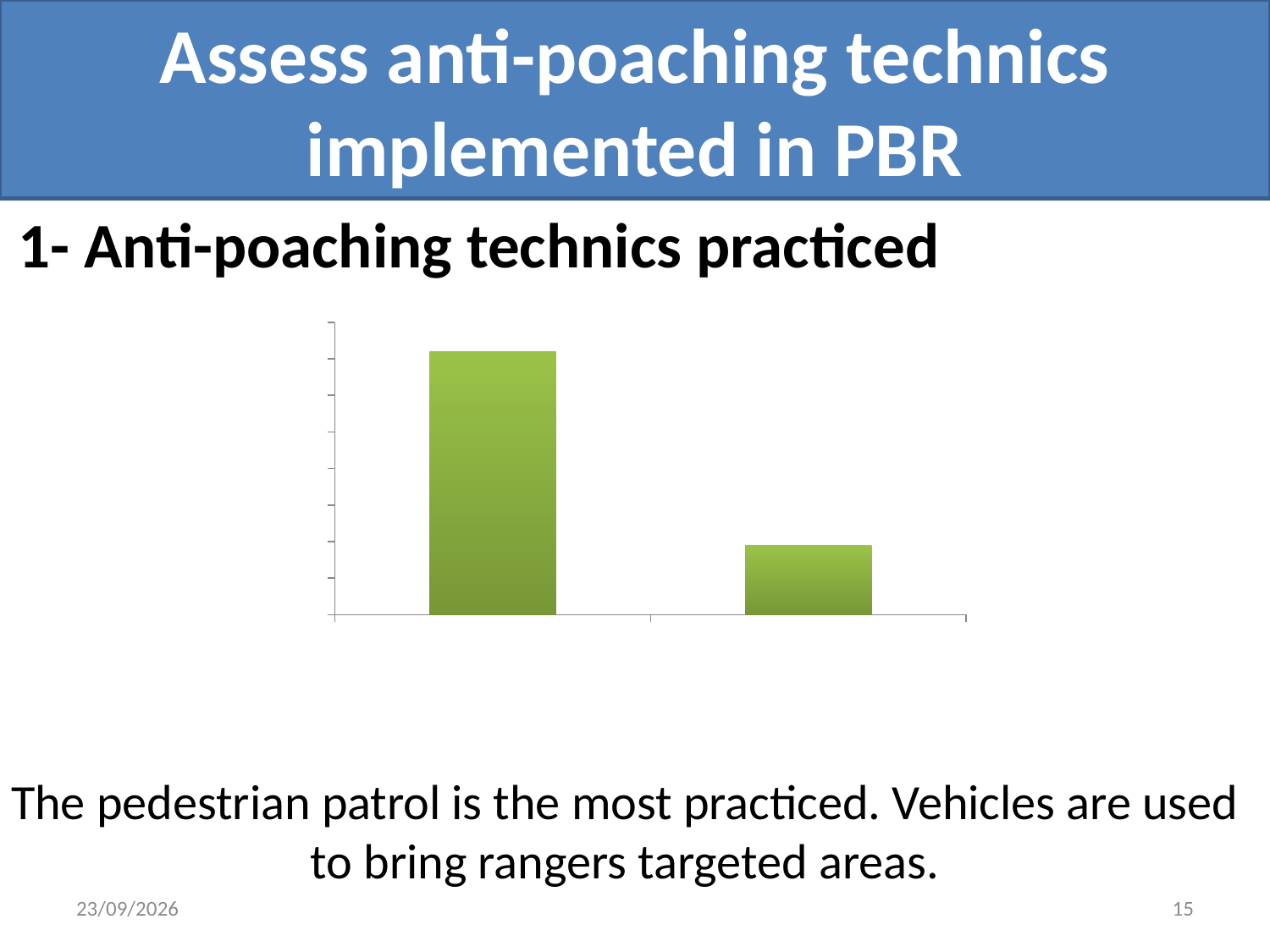
How many bars are plotted in the chart? 2 Which bar in the chart is the shortest, the left one or the right one? the right one What kind of chart is shown on the slide? bar chart Does the chart display a legend? No Do the bar heights rise or fall from left to right across the chart? fall Which bar is taller in the chart, the left one or the right one? the left one What colour are the bars in the chart? green